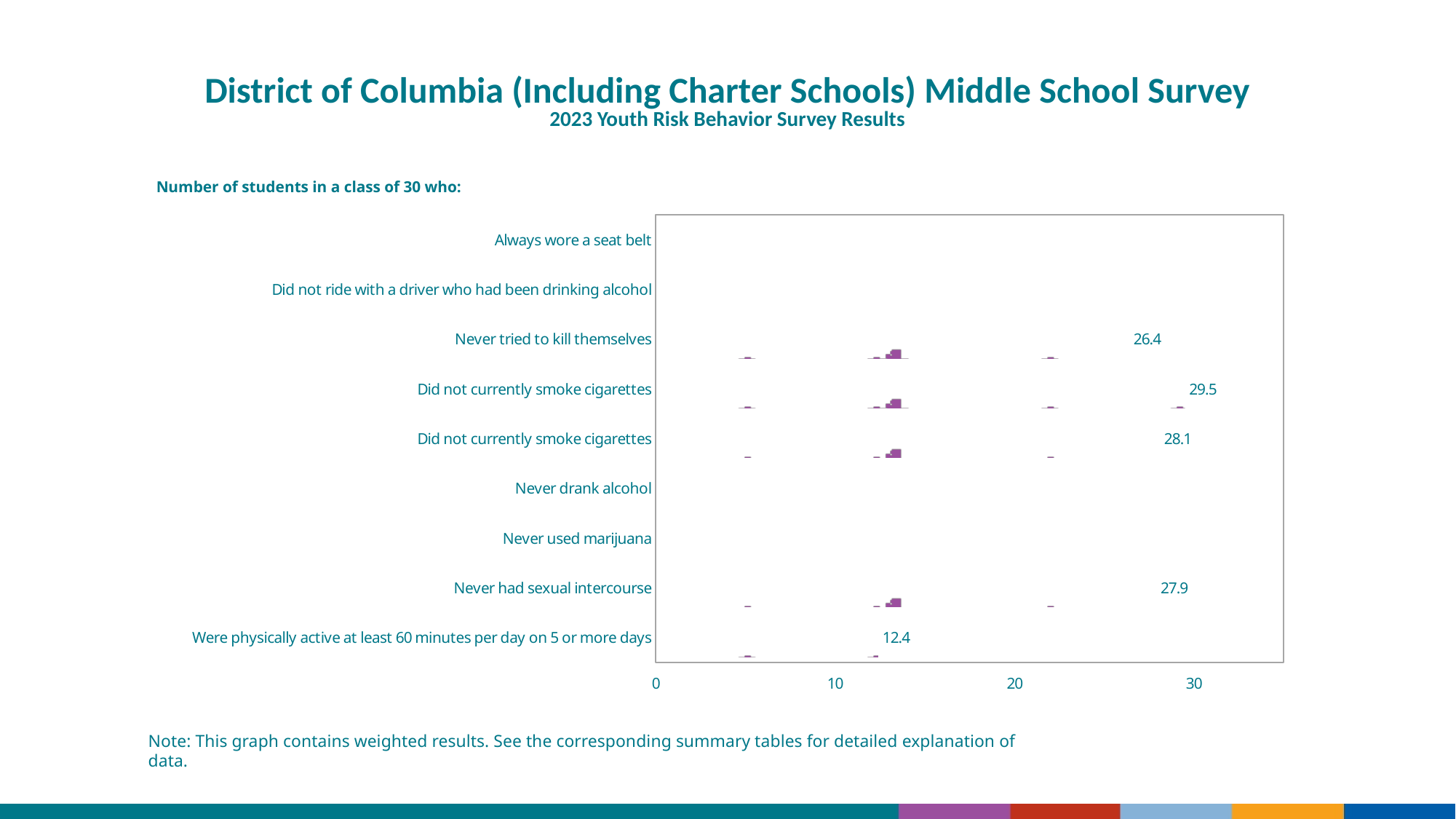
What is the value for 'Were physically active at least 60 minutes per day on 5 or more days'? 12.4 What is the title of the slide containing the chart? District of Columbia (Including Charter Schools) Middle School Survey What is the value for 'Never had sexual intercourse'? 27.9 What is the value shown for the second of the two 'Did not currently smoke cigarettes' rows? 28.1 What is the difference between the values for 'Never had sexual intercourse' and 'Were physically active at least 60 minutes per day on 5 or more days'? 15.5 What is the value shown for the first of the two 'Did not currently smoke cigarettes' rows? 29.5 What is the value for 'Never tried to kill themselves'? 26.4 What is the difference between the values for 'Never had sexual intercourse' and 'Never tried to kill themselves'? 1.5 Which category has the lowest labeled value? Were physically active at least 60 minutes per day on 5 or more days How many categories are listed on the vertical axis of the chart? 9 Which is larger, the value for 'Never had sexual intercourse' or the value for 'Never tried to kill themselves'? Never had sexual intercourse Is the value for 'Were physically active at least 60 minutes per day on 5 or more days' greater or less than 20? less